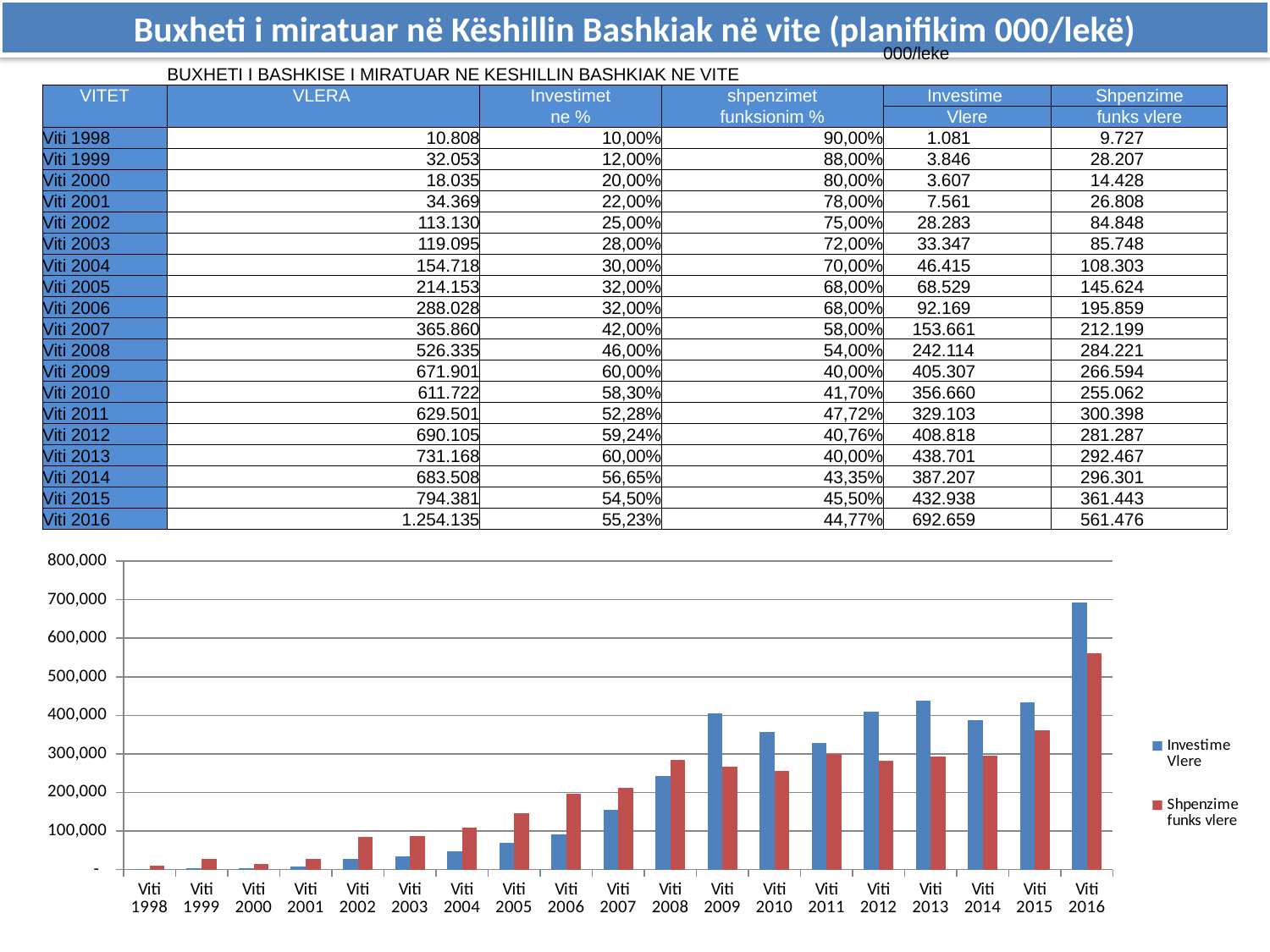
Is the Shpenzime funks vlere value for Viti 2015 greater or less than 300,000? greater What kind of chart is shown at the bottom of the slide? bar chart For Viti 2008, which is larger: Investime Vlere or Shpenzime funks vlere? Shpenzime funks vlere Is the Investime Vlere value for Viti 2016 greater or less than 600,000? greater How many series does the chart's legend list? 2 For Viti 2009, which is larger: Investime Vlere or Shpenzime funks vlere? Investime Vlere In which year is the Investime Vlere bar the highest? Viti 2016 According to the table, what is the Investime Vlere value for Viti 2016? 692.659 Which colour represents Shpenzime funks vlere in the chart? red In which year is the Shpenzime funks vlere bar the lowest? Viti 1998 Do the Investime Vlere values generally rise or fall from Viti 1998 to Viti 2016? rise How many years (categories) are plotted along the x axis of the chart? 19